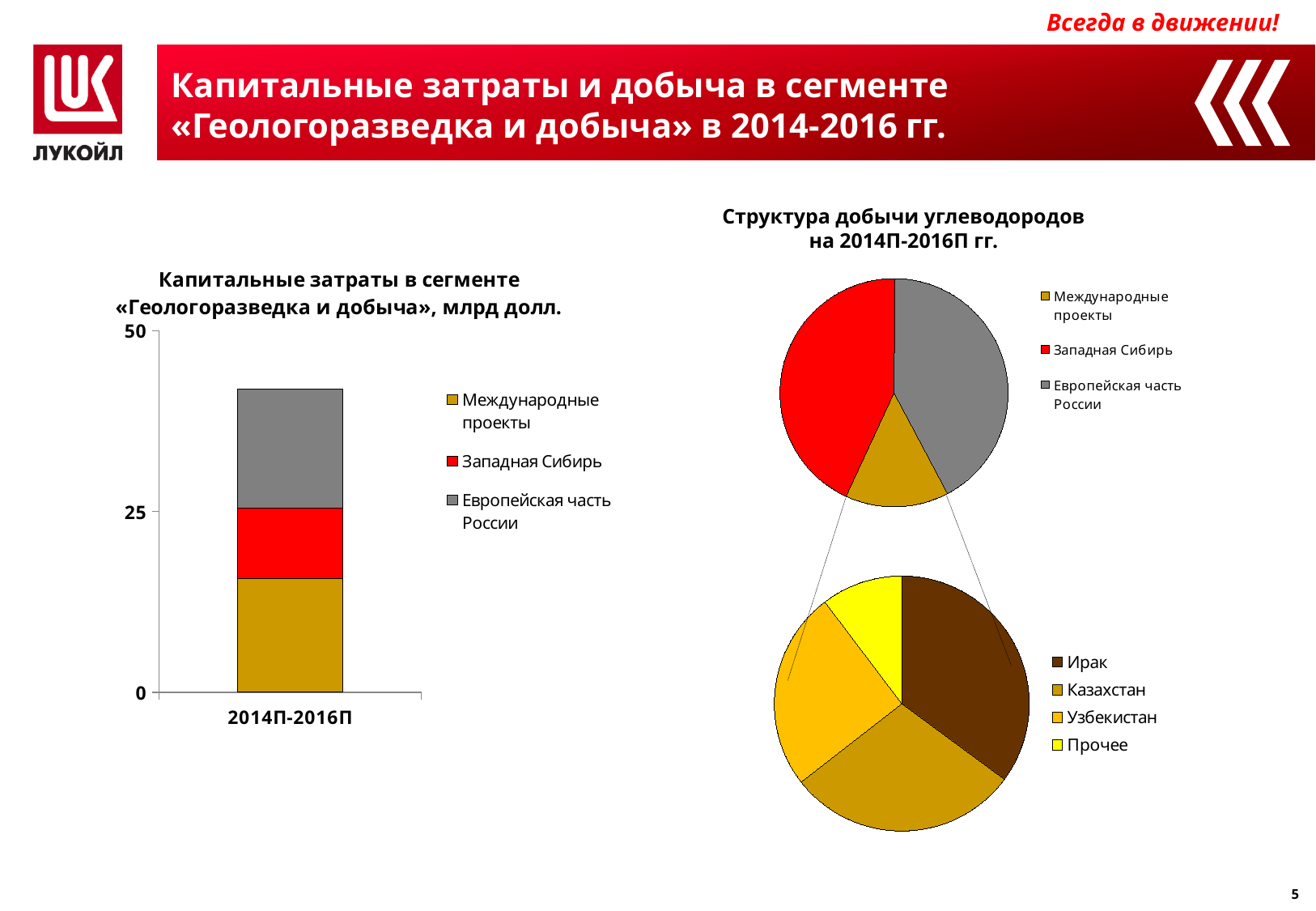
What kind of chart is the chart titled «Структура добычи углеводородов на 2014П-2016П гг.»? Pie chart In the bar chart «Капитальные затраты в сегменте «Геологоразведка и добыча», млрд долл.», is the total height of the stacked bar for 2014П-2016П greater or less than 50? less In the bar chart «Капитальные затраты в сегменте «Геологоразведка и добыча», млрд долл.», is the total height of the stacked bar for 2014П-2016П greater or less than 25? greater In the bar chart «Капитальные затраты в сегменте «Геологоразведка и добыча», млрд долл.», is the value of the «Международные проекты» segment greater or less than 25? less In the pie chart «Структура добычи углеводородов на 2014П-2016П гг.», which slice of the breakdown pie of international projects is the largest? Ирак In the bar chart «Капитальные затраты в сегменте «Геологоразведка и добыча», млрд долл.», what is the label of the category on the x axis? 2014П-2016П In the pie chart «Структура добычи углеводородов на 2014П-2016П гг.», how many slices does the breakdown pie of international projects have? 4 In the pie chart «Структура добычи углеводородов на 2014П-2016П гг.», which slice of the main pie is the smallest? Международные проекты In the bar chart «Капитальные затраты в сегменте «Геологоразведка и добыча», млрд долл.», how many categories are shown on the x axis? 1 What kind of chart is the chart titled «Капитальные затраты в сегменте «Геологоразведка и добыча», млрд долл.»? Stacked bar chart In the bar chart «Капитальные затраты в сегменте «Геологоразведка и добыча», млрд долл.», which segment is larger: «Международные проекты» or «Западная Сибирь»? Международные проекты In the bar chart «Капитальные затраты в сегменте «Геологоразведка и добыча», млрд долл.», how many series does the legend list? 3